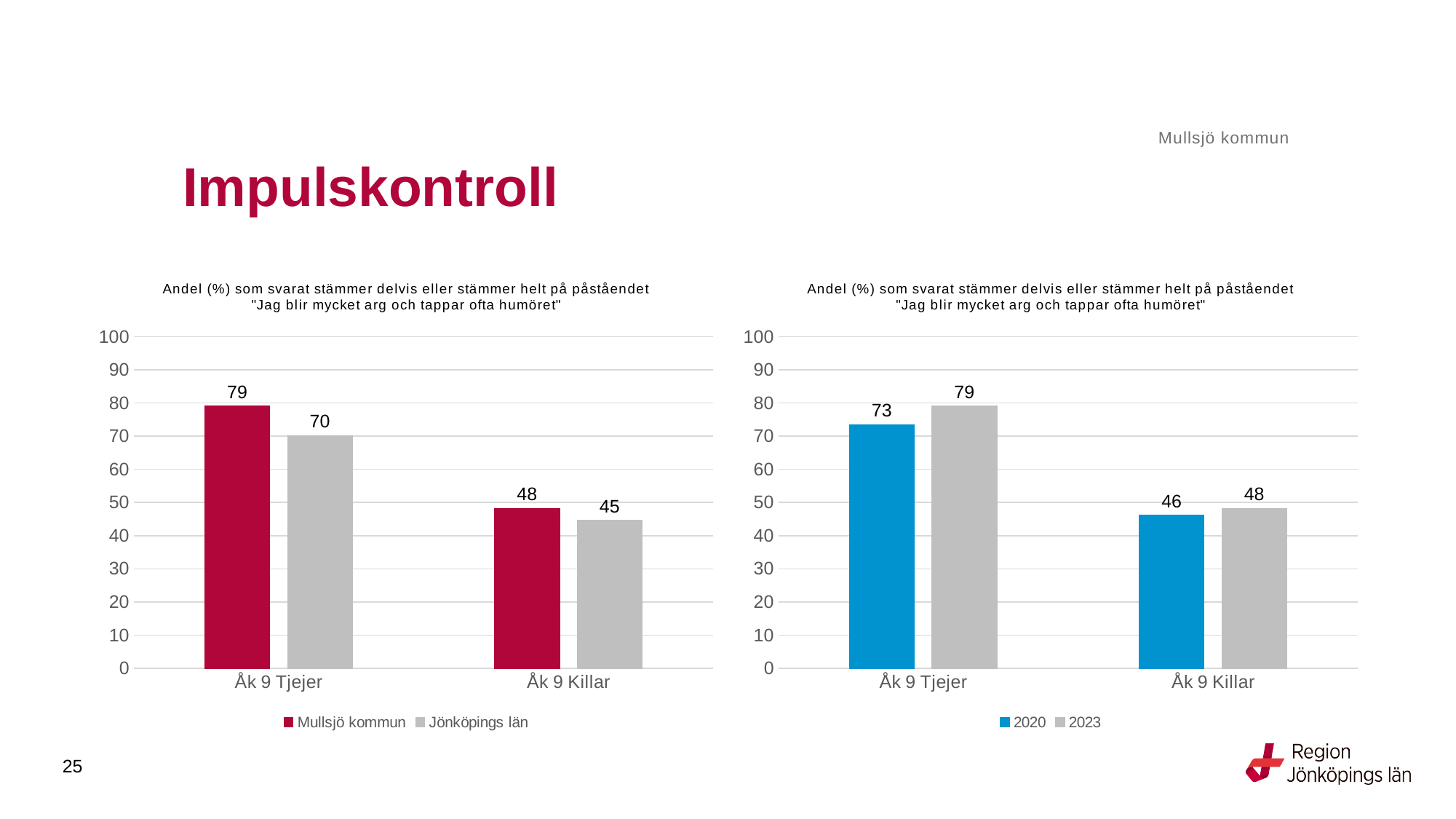
In the left chart, what is the difference between Mullsjö kommun and Jönköpings län for Åk 9 Tjejer? 9 In the right chart, what is the difference between 2023 and 2020 for Åk 9 Tjejer? 6 What kind of chart is the left chart? Bar chart In the right chart, which series is shown in blue? 2020 In the right chart, what is the value for 2020 for Åk 9 Tjejer? 73 In the left chart, what is the value for Mullsjö kommun for Åk 9 Tjejer? 79 In the right chart, what is the value for 2023 for Åk 9 Killar? 48 In the right chart, which category has the highest value for 2023? Åk 9 Tjejer In the left chart, what is the value for Jönköpings län for Åk 9 Killar? 45 In the left chart, which is larger for Åk 9 Killar: Mullsjö kommun or Jönköpings län? Mullsjö kommun In the left chart, which bar has the lowest value? Jönköpings län, Åk 9 Killar How many series does the legend of the right chart list? 2